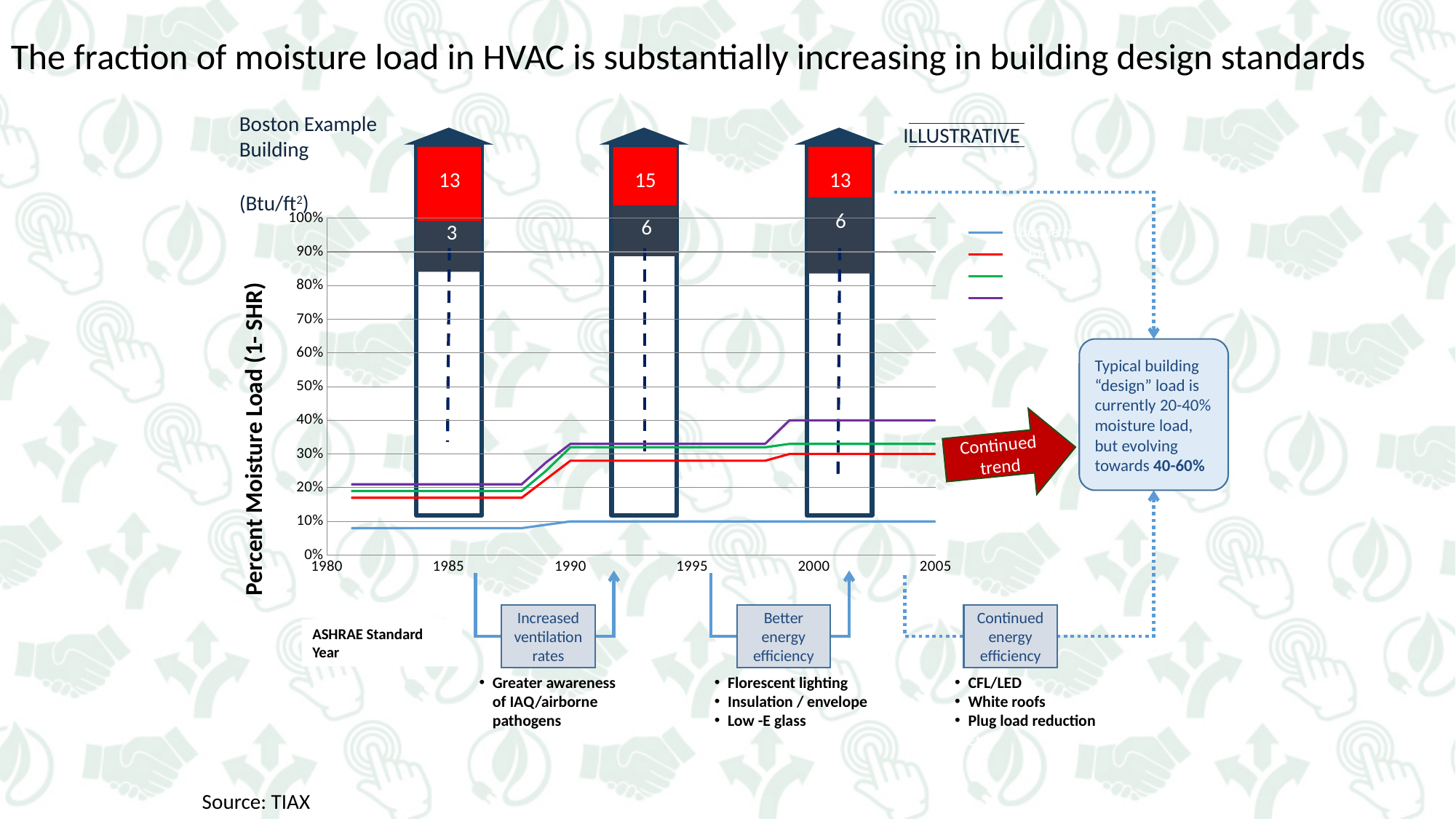
What kind of chart is shown on the slide? line chart Does the purple line rise or fall from 1980 to 2005? rise At 2005, is the blue line greater or less than 20%? less What is the label on the vertical axis of the chart? Percent Moisture Load (1- SHR) How many coloured lines are plotted on the chart? 4 What is the red value shown on the middle building graphic (around 1992)? 15 At 2005, is the purple line greater or less than 30%? greater What source is cited for the chart? TIAX Which coloured line is highest at 2005? purple At 2005, which is higher, the purple line or the red line? purple What is the red value shown on the building graphic above 1985? 13 Which coloured line is lowest across the chart? blue